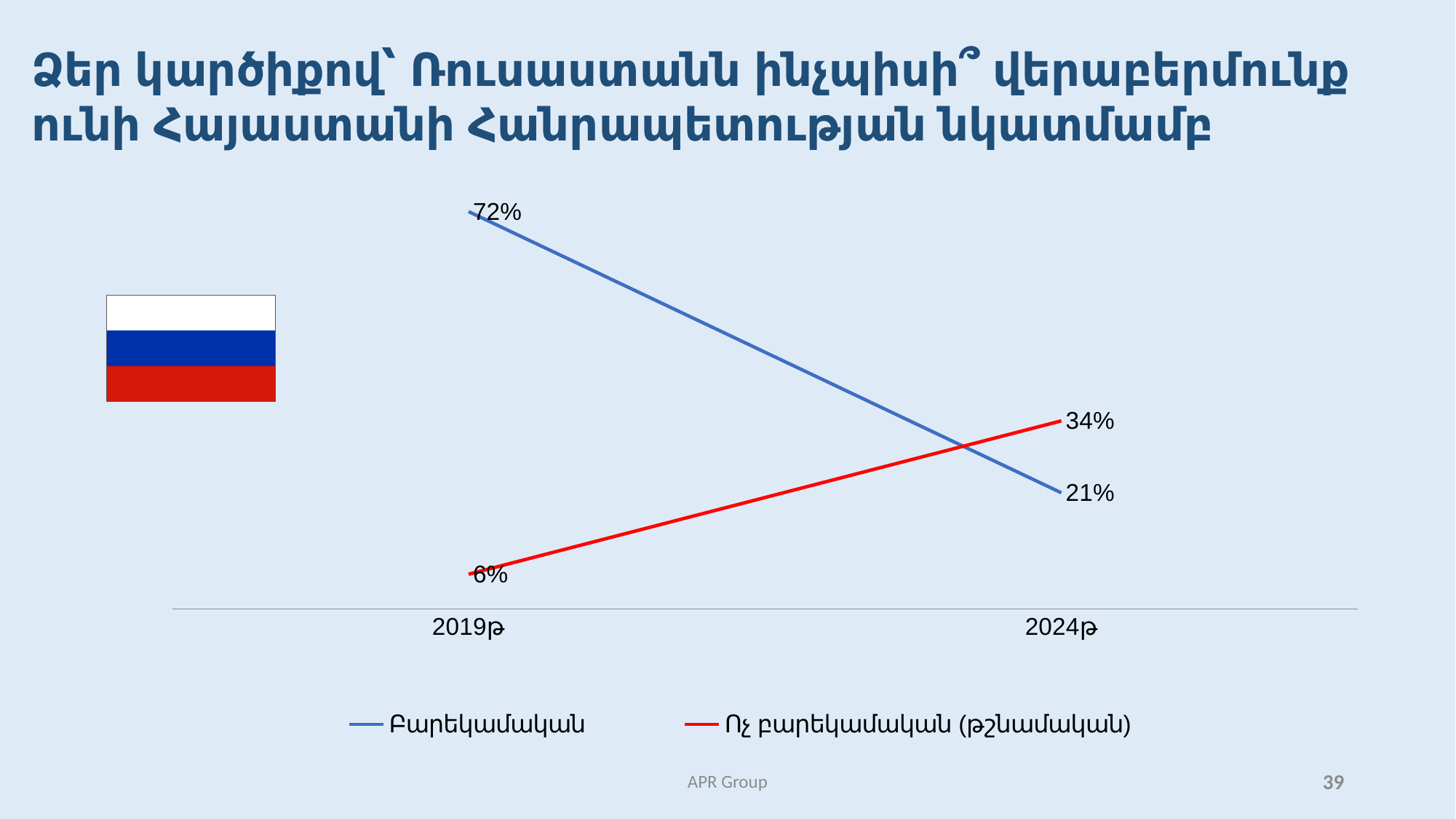
By how many percentage points did the Բարեկամական series change between 2019թ and 2024թ? 51 percentage points How many series does the legend list? 2 What is the value of the Ոչ բարեկամական (թշնամական) series in 2024թ? 34% What is the value of the Բարեկամական series in 2024թ? 21% How many points on the x axis does the chart show? 2 Does the Բարեկամական series rise or fall from 2019թ to 2024թ? fall What colour is the line for the Ոչ բարեկամական (թշնամական) series? red In 2024թ, which series has the higher value, Բարեկամական or Ոչ բարեկամական (թշնամական)? Ոչ բարեկամական (թշնամական) What is the value of the Բարեկամական series in 2019թ? 72% What is the value of the Ոչ բարեկամական (թշնամական) series in 2019թ? 6% Does the Ոչ բարեկամական (թշնամական) series rise or fall from 2019թ to 2024թ? rise What kind of chart is shown on the slide? line chart